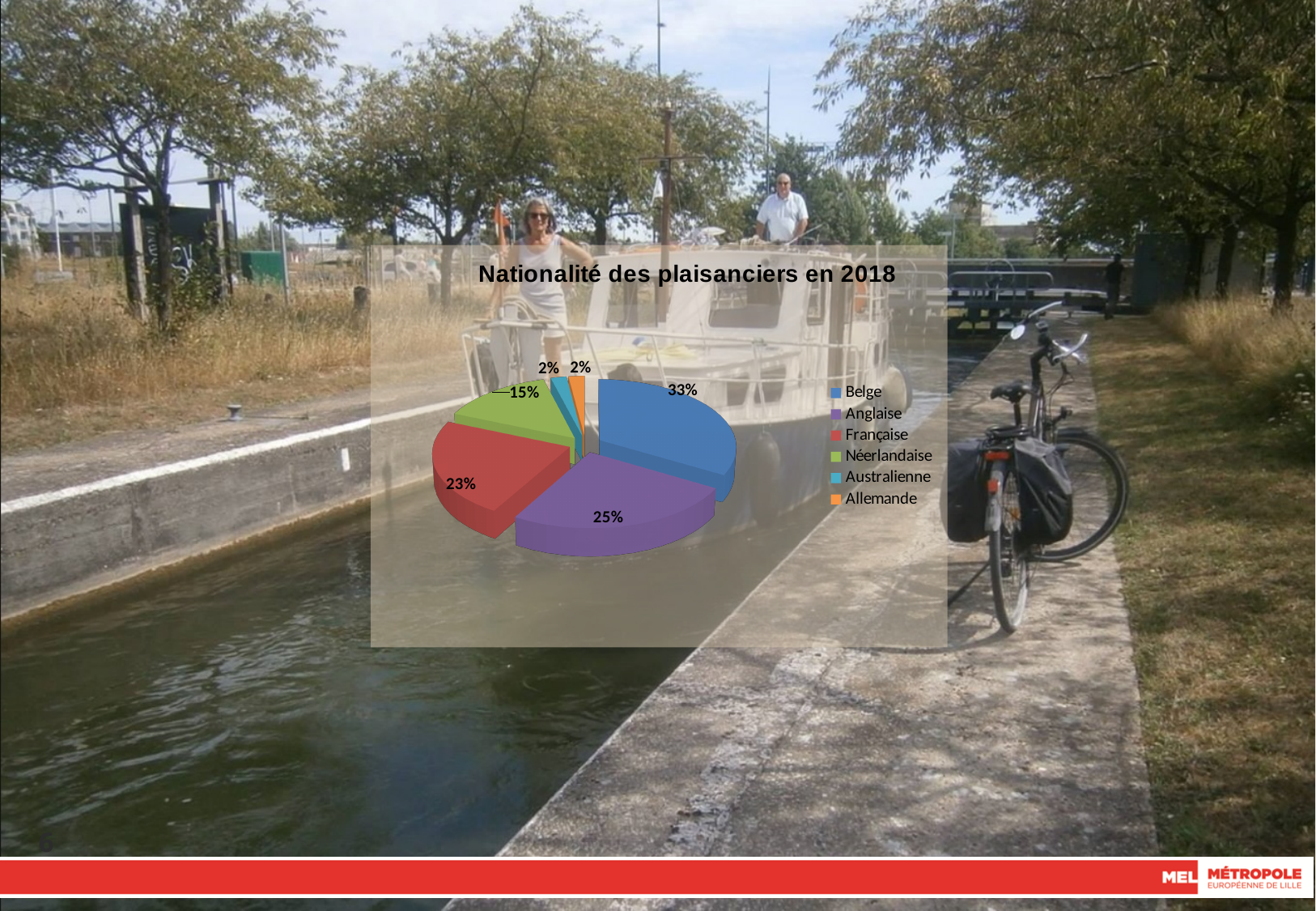
How many categories does the legend list? 6 What share of the pie does Belge represent? 33% Which nationality has the largest share of the pie? Belge What percentage is shown for Australienne? 2% What percentage is shown for Française? 23% What type of chart is shown on the slide? Pie chart What is the title of the chart? Nationalité des plaisanciers en 2018 What is the difference in percentage points between Belge and Française? 10 What percentage is shown for Néerlandaise? 15% What percentage is shown for Anglaise? 25% What colour is the slice for Allemande? Orange Which has a larger share, Anglaise or Néerlandaise? Anglaise